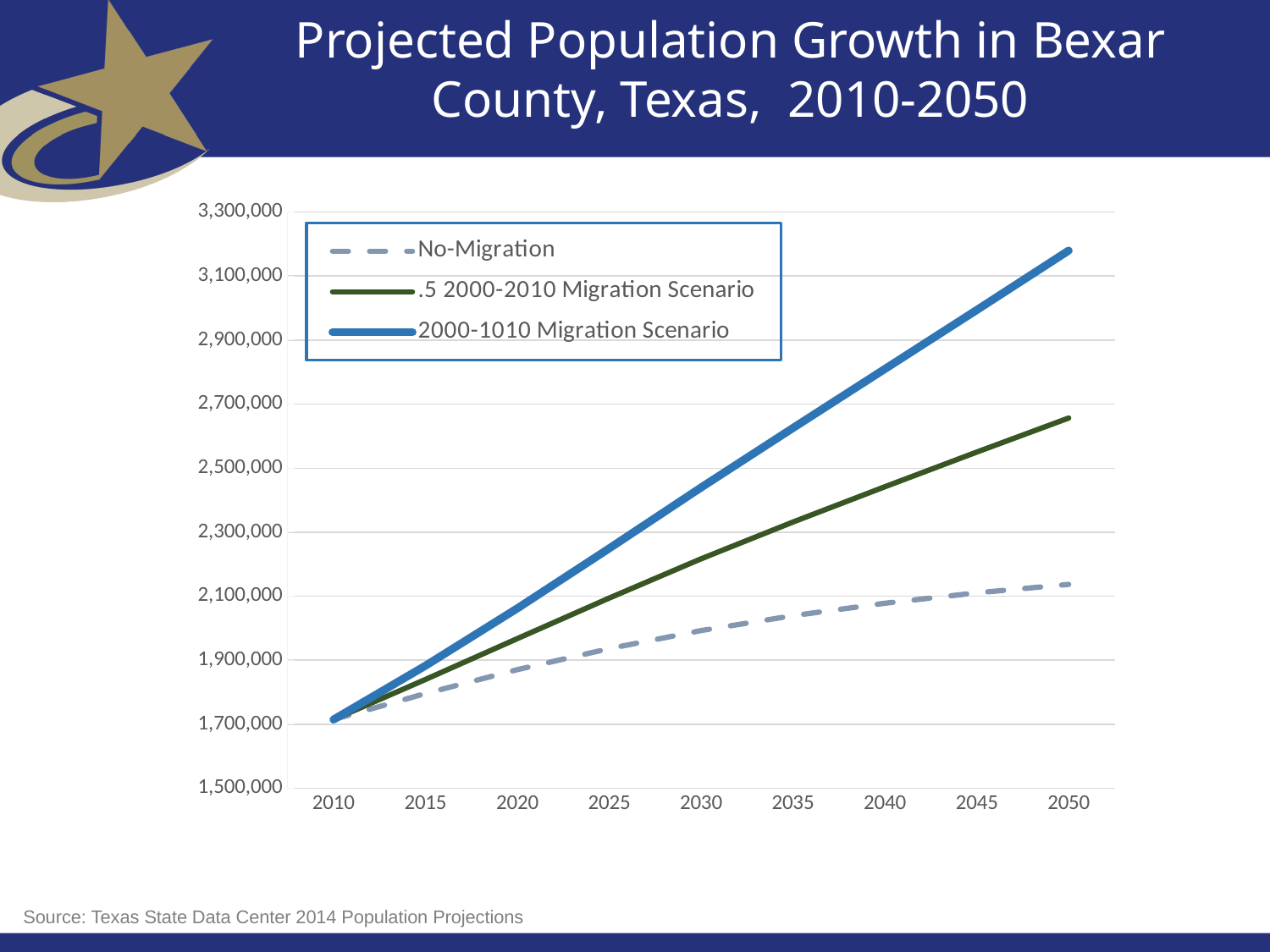
Which series is drawn with a dashed line? No-Migration Is the 2050 value for the No-Migration series greater or less than 2,300,000? less In 2040, which is larger: the .5 2000-2010 Migration Scenario or the No-Migration series? .5 2000-2010 Migration Scenario Which series has the lowest projected population in 2050? No-Migration Is the 2050 value for the 2000-1010 Migration Scenario greater or less than 3,100,000? greater Is the 2030 value for the No-Migration series greater or less than 2,100,000? less Do the values for the No-Migration series rise or fall from 2010 to 2050? rise What kind of chart is shown on the slide? line chart Which series has the highest projected population in 2050? 2000-1010 Migration Scenario How many year ticks are shown on the x axis? 9 How many series does the legend list? 3